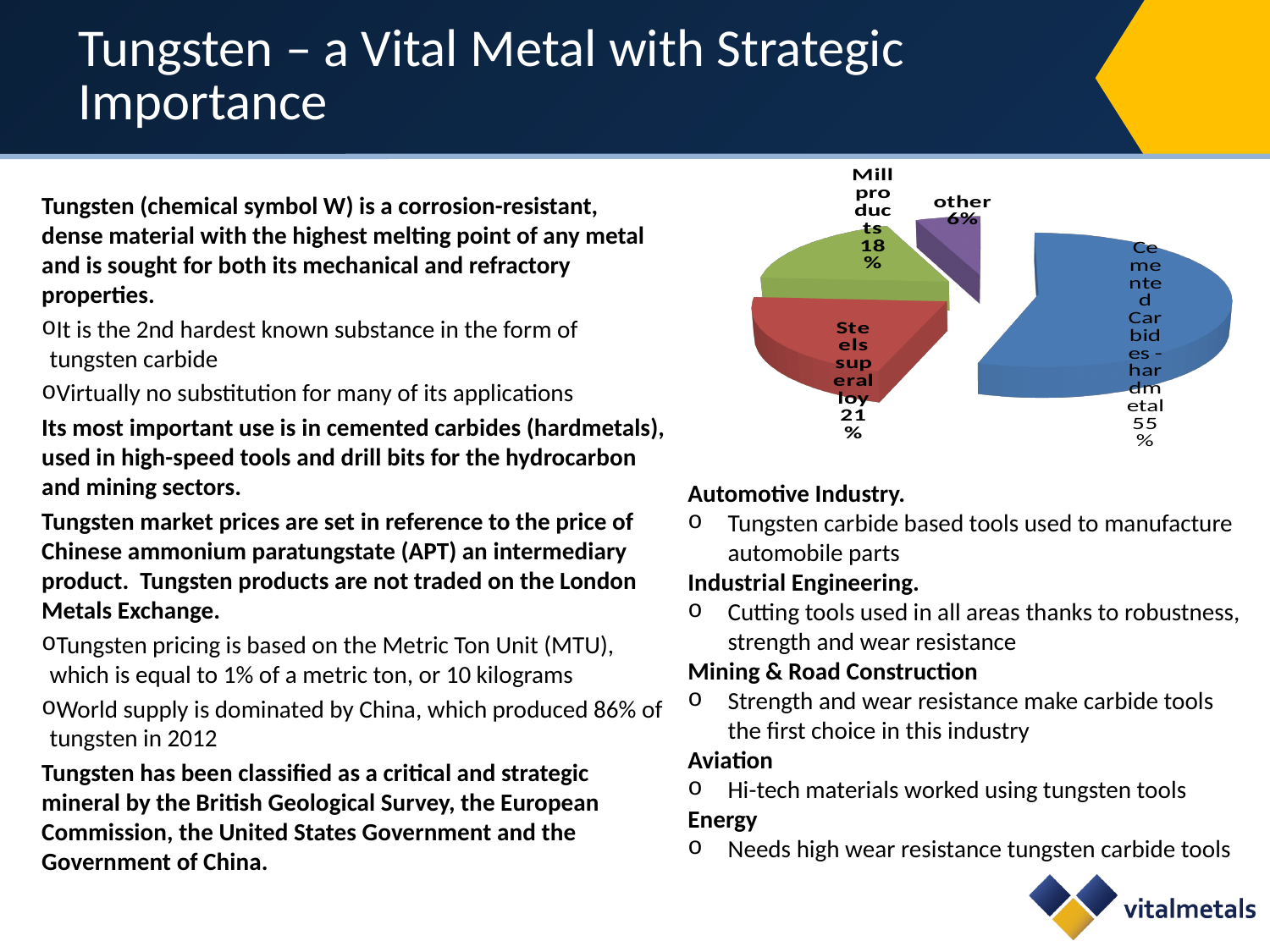
Which is larger, the Steels superalloy slice or the Mill products slice? Steels superalloy What is the difference in percentage points between Cemented Carbides - hardmetal and Steels superalloy? 34 What share of the pie does the 'other' slice have? 6% How many slices does the pie chart have? 4 What kind of chart is shown on the slide? pie chart What share of the pie does Cemented Carbides - hardmetal have? 55% What share of the pie does Steels superalloy have? 21% What colour is the Cemented Carbides - hardmetal slice? blue Which slice of the pie chart is the largest? Cemented Carbides - hardmetal Which slice of the pie chart is the smallest? other What is the difference in percentage points between Mill products and other? 12